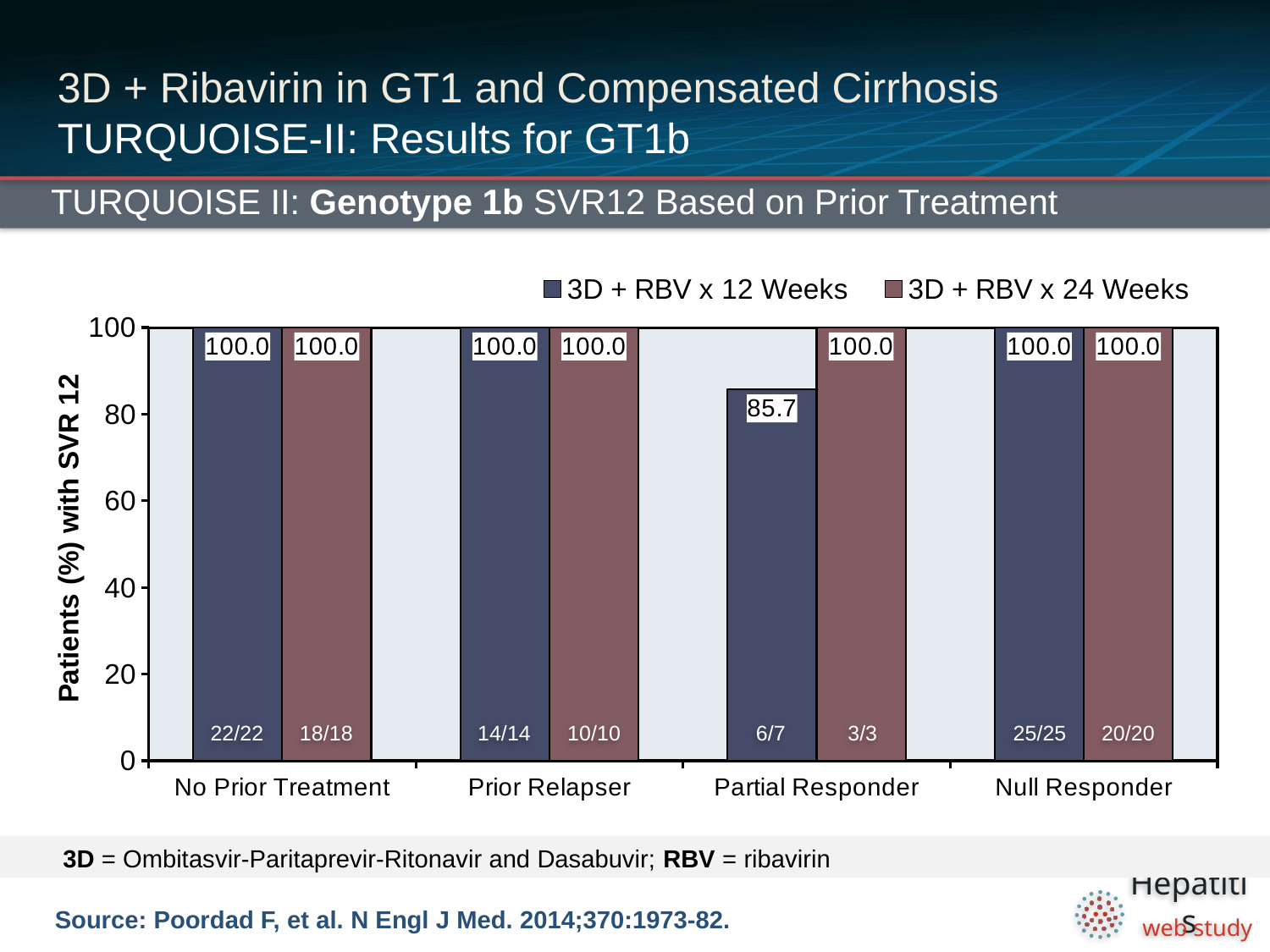
What is the SVR12 rate for Partial Responder patients treated with 3D + RBV x 12 Weeks? 85.7 What is the SVR12 rate for No Prior Treatment patients treated with 3D + RBV x 12 Weeks? 100.0 What kind of chart is shown on the slide? Bar chart Which category has the lowest SVR12 rate for the 3D + RBV x 12 Weeks series? Partial Responder For Partial Responder, which series has the higher SVR12 rate, 3D + RBV x 12 Weeks or 3D + RBV x 24 Weeks? 3D + RBV x 24 Weeks How many prior treatment categories are shown on the x axis? 4 How many patients are represented by the Prior Relapser bar for 3D + RBV x 12 Weeks? 14/14 How many series does the legend list? 2 What is the label of the y axis? Patients (%) with SVR 12 What is the difference between the 3D + RBV x 24 Weeks and 3D + RBV x 12 Weeks SVR12 rates for Partial Responder? 14.3 Is the SVR12 rate for Partial Responder with 3D + RBV x 12 Weeks greater or less than 80? greater What is the SVR12 rate for Null Responder patients treated with 3D + RBV x 24 Weeks? 100.0